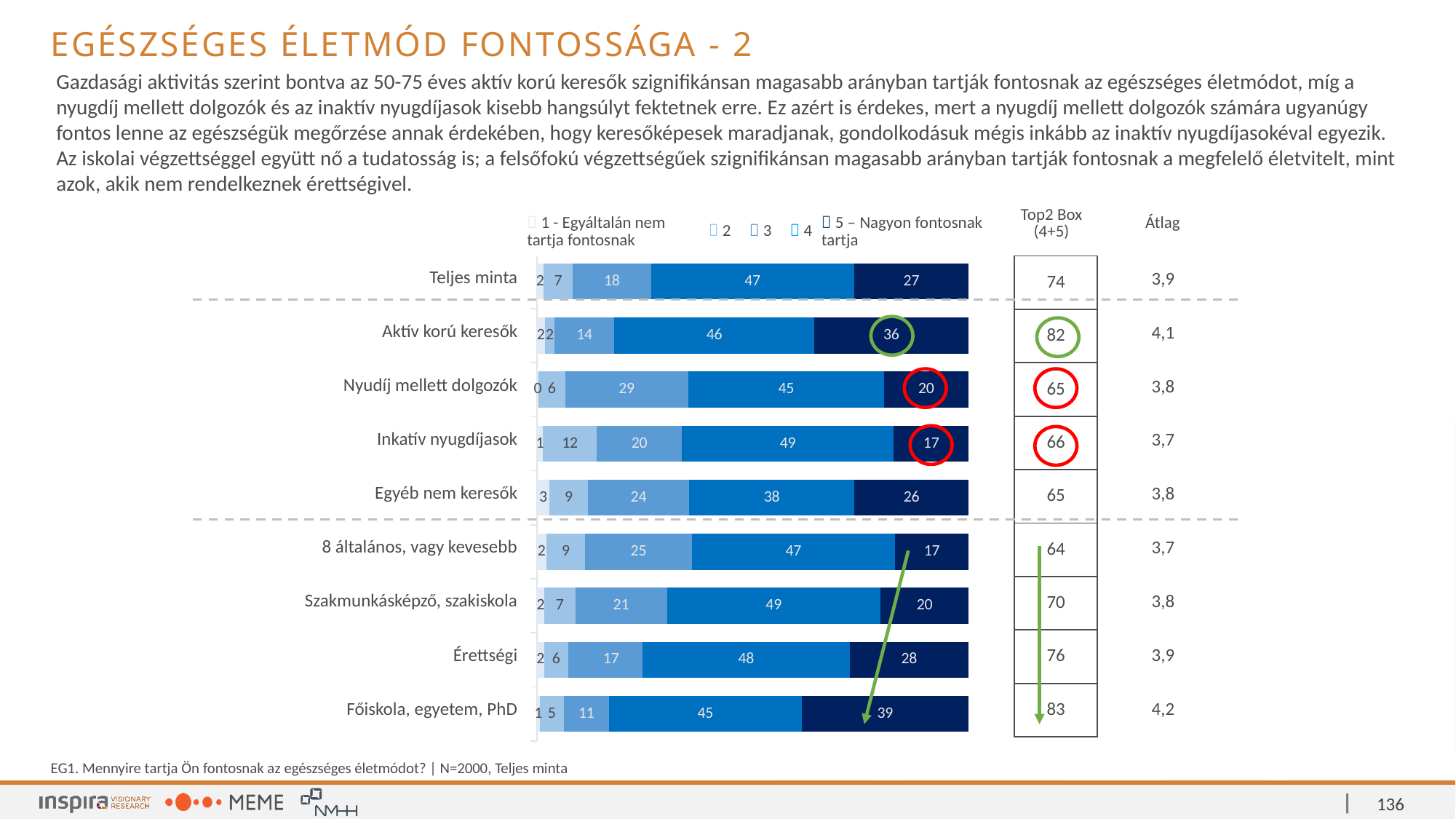
How many series does the legend list? 5 What is the Átlag value shown for Főiskola, egyetem, PhD? 4,2 Which category has the highest value for "5 – Nagyon fontosnak tartja"? Főiskola, egyetem, PhD Which category has the lowest Top2 Box (4+5) value? 8 általános, vagy kevesebb What is the difference between the Top2 Box (4+5) values of Aktív korú keresők and Nyudíj mellett dolgozók? 17 How many categories (bars) are shown in the chart? 9 What is the value for "5 – Nagyon fontosnak tartja" in the Teljes minta bar? 27 What is the value for series "4" in the Inkatív nyugdíjasok bar? 49 Which has a larger value for series "4": Aktív korú keresők or Egyéb nem keresők? Aktív korú keresők What kind of chart is shown on the slide? Stacked bar chart What is the total of the stacked bar for Nyudíj mellett dolgozók? 100 What is the value for series "3" in the Nyudíj mellett dolgozók bar? 29